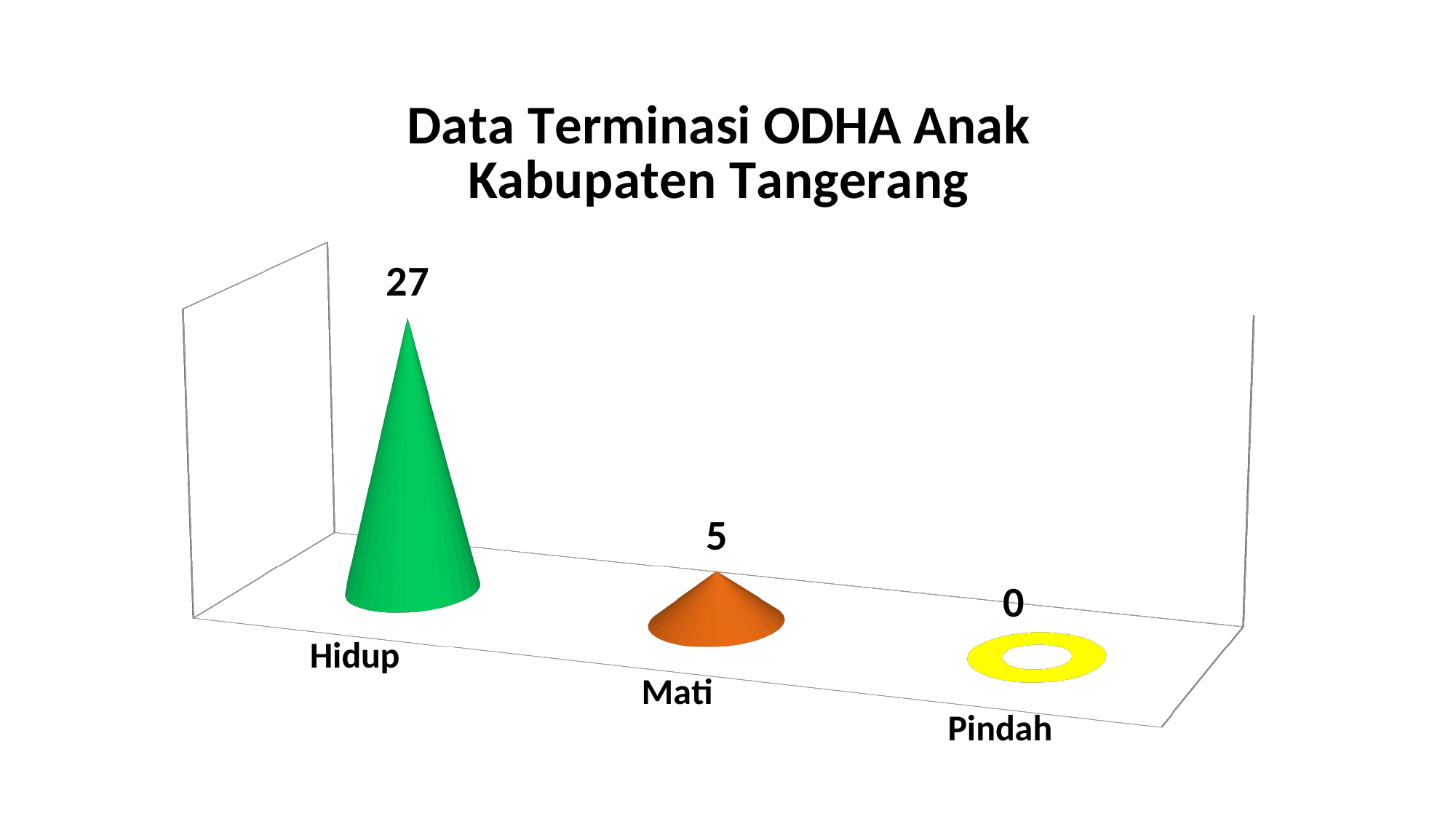
What is the value for Mati? 5 Which category has the highest value? Hidup Which is larger, the value for Mati or the value for Pindah? Mati What is the difference between the values for Hidup and Mati? 22 Which category has the lowest value? Pindah What kind of chart is this? Bar chart What is the value for Hidup? 27 What is the value for Pindah? 0 How many categories are shown in the chart? 3 Do the values rise or fall from Hidup to Pindah? Fall What colour is the shape for Hidup? Green What is the title of the chart? Data Terminasi ODHA Anak Kabupaten Tangerang